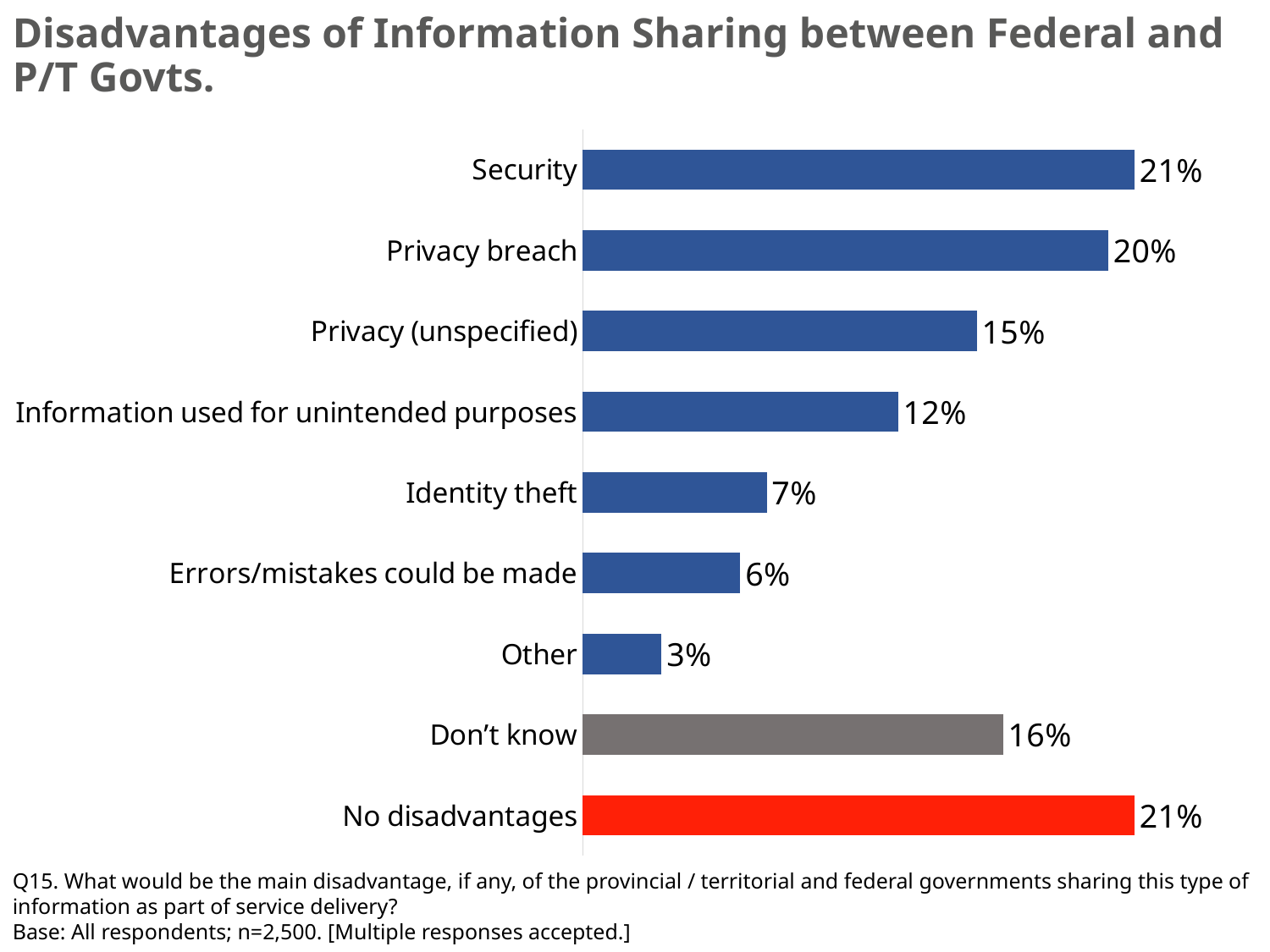
Which is larger, the value for Don't know or the value for Privacy (unspecified)? Don't know How many categories are shown on the chart? 9 What percentage of respondents cited Security as a disadvantage? 21% What is the value for Don't know? 16% What type of chart is shown on the slide? Bar chart Which category has the lowest value on the chart? Other Which is larger, Identity theft or Errors/mistakes could be made? Identity theft What is the difference between the values for Privacy (unspecified) and Identity theft? 8% What percentage is shown for Information used for unintended purposes? 12% Which category's bar is coloured red? No disadvantages What is the difference between Privacy breach and Errors/mistakes could be made? 14% What is the value shown for Privacy breach? 20%